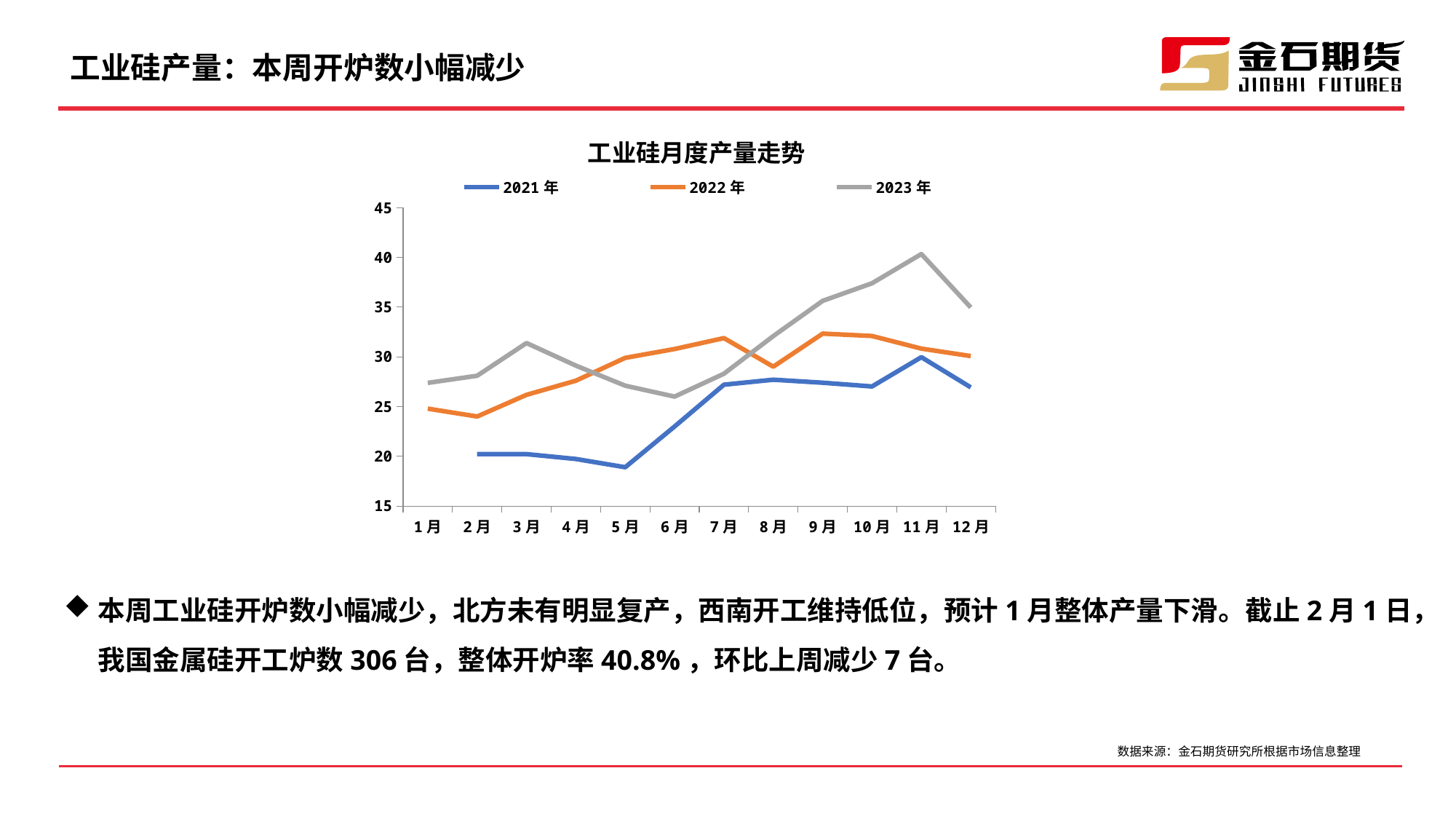
In which month does the 2022年 series reach its lowest value? 2月 How many series does the legend list? 3 Does the 2021年 series rise or fall from 5月 to 7月? rise How many months are shown on the x axis? 12 In which month does the 2021年 series reach its lowest value? 5月 Which series is drawn in grey? 2023年 Is the value for 2021年 in 2月 greater or less than 25? less What kind of chart is shown on the slide? line chart Is the value for 2023年 in 11月 greater or less than 35? greater In which month does the 2023年 series reach its highest value? 11月 In 12月, which series has the larger value, 2023年 or 2022年? 2023年 What is the title of the chart? 工业硅月度产量走势